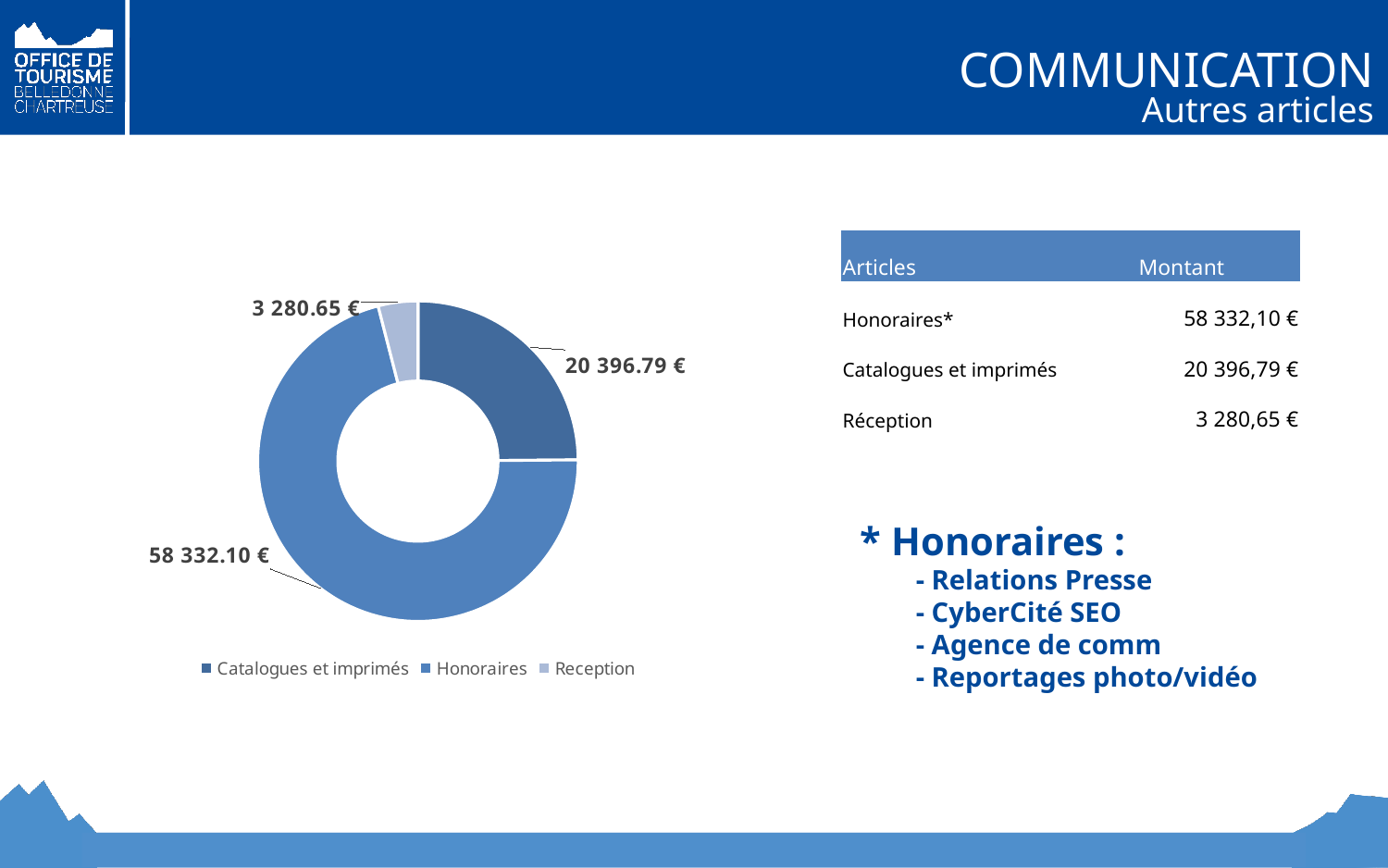
Which category has the smallest slice in the chart? Reception What is the value shown for Catalogues et imprimés in the chart? 20 396.79 € What kind of chart is shown on the slide? doughnut chart Which category has the largest slice in the chart? Honoraires What is the difference between the Catalogues et imprimés value and the Reception value? 17 116.14 € What are the three entries listed in the chart legend? Catalogues et imprimés, Honoraires, Reception Which is larger, the value for Catalogues et imprimés or the value for Reception? Catalogues et imprimés How many categories are shown in the chart? 3 What is the difference between the Honoraires value and the Catalogues et imprimés value? 37 935.31 € What is the value shown for Reception in the chart? 3 280.65 € What is the value shown for Honoraires in the doughnut chart? 58 332.10 €